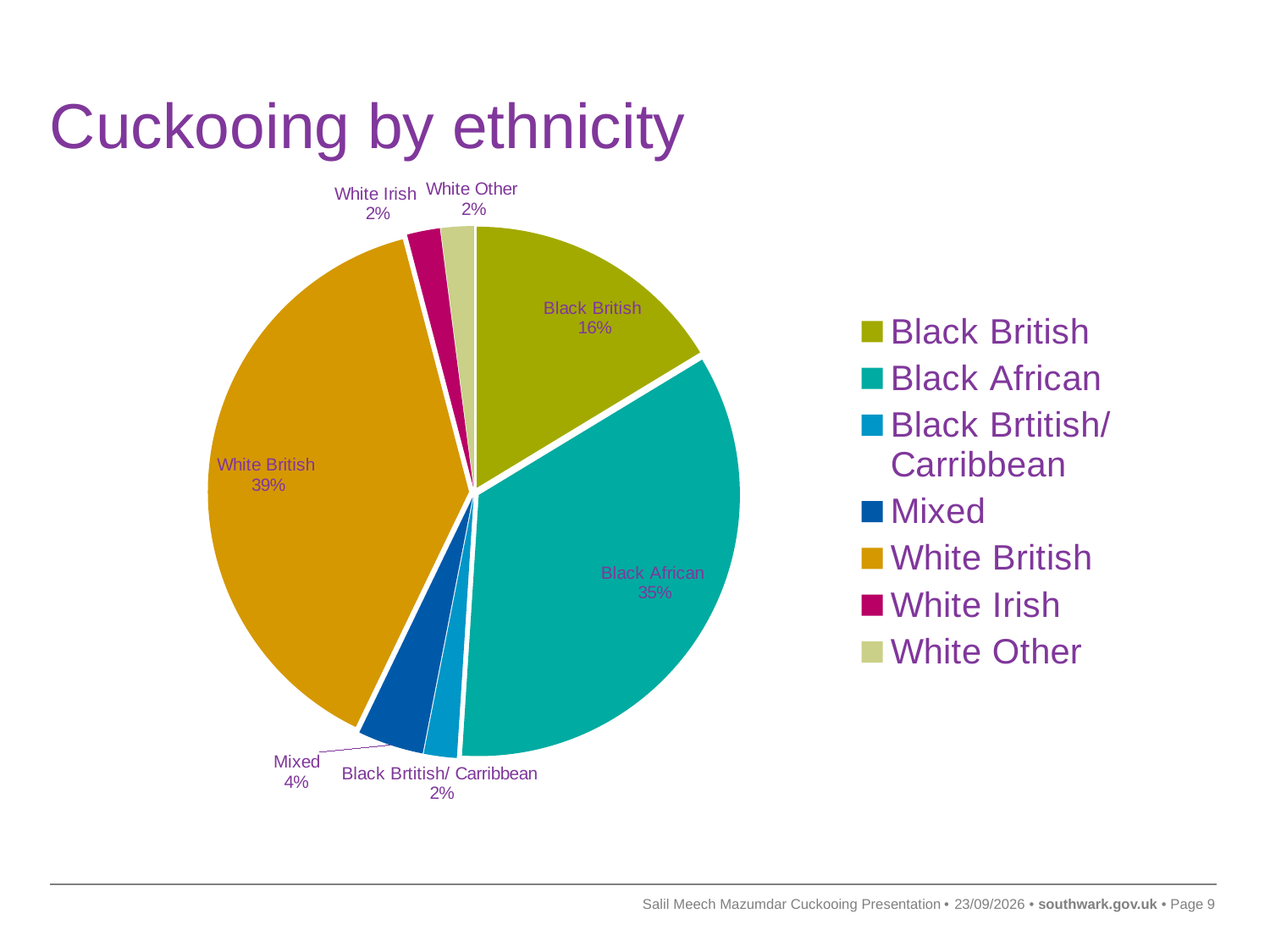
What is the difference in percentage points between White British and Black African? 4 What type of chart is shown on the slide? Pie chart Which is larger, the Black British slice or the Mixed slice? Black British What is the title of the slide? Cuckooing by ethnicity What percentage is shown for Black African? 35% Which ethnicity has the largest slice of the pie? White British What is the difference in percentage points between Black African and Black British? 19 What share of the pie does White British account for? 39% What percentage is shown for Black British? 16% What percentage is shown for Mixed? 4% How many categories does the pie chart show? 7 How many entries does the legend list? 7